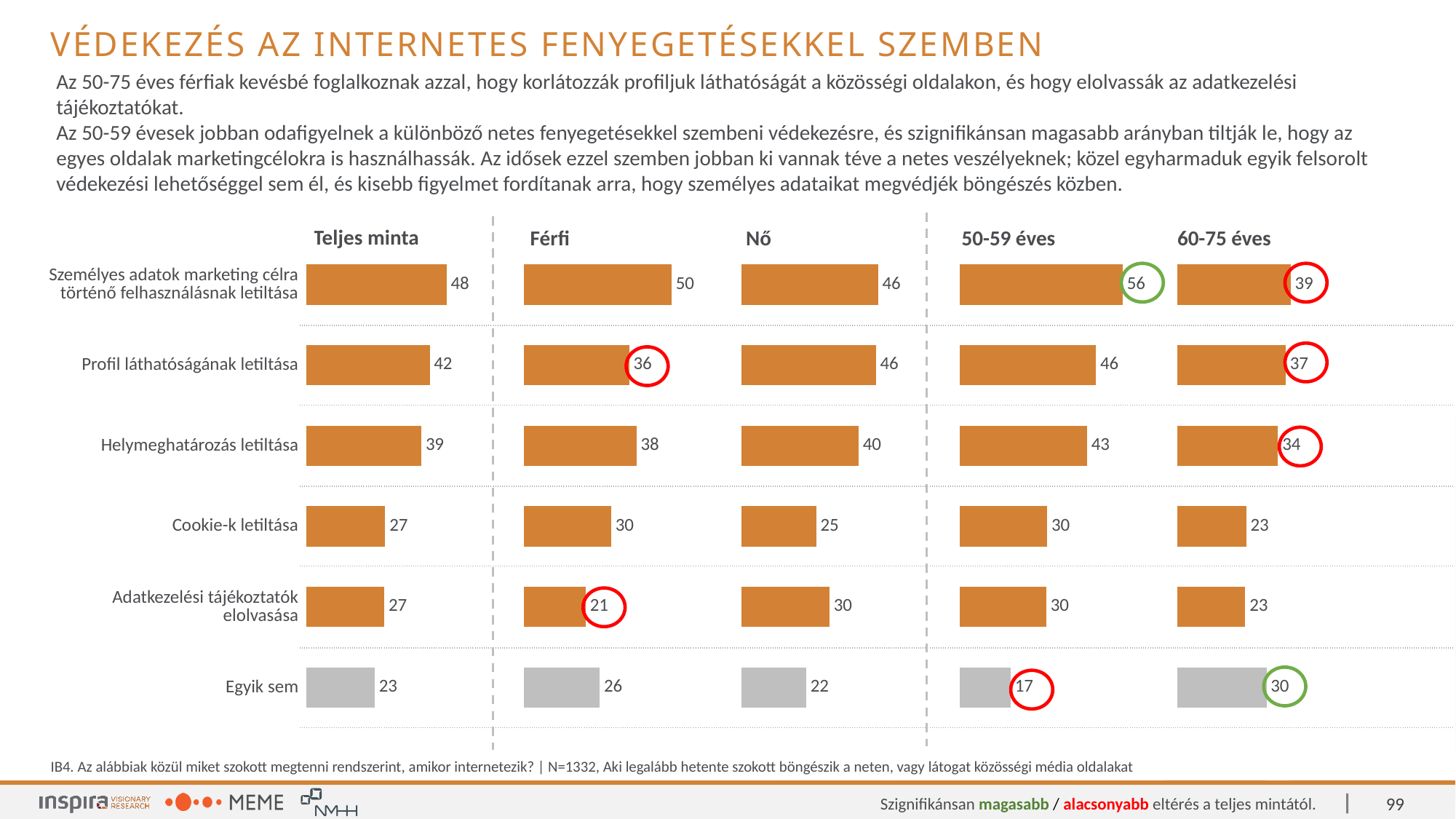
In the "Nő" chart, which category has the lowest value? Egyik sem What is the difference between the "50-59 éves" and "60-75 éves" values for "Személyes adatok marketing célra történő felhasználásnak letiltása"? 17 In the "50-59 éves" chart, which category has the highest value? Személyes adatok marketing célra történő felhasználásnak letiltása In the "Teljes minta" chart, what is the value for "Személyes adatok marketing célra történő felhasználásnak letiltása"? 48 In the "60-75 éves" chart, what is the value for "Egyik sem"? 30 What kind of chart is used on this slide? Bar chart How many categories are shown in the "Teljes minta" chart? 6 For "Profil láthatóságának letiltása", which is larger: the "Férfi" value or the "Nő" value? Nő In the "Férfi" chart, what is the difference between "Cookie-k letiltása" and "Adatkezelési tájékoztatók elolvasása"? 9 In the "Nő" chart, what is the value for "Helymeghatározás letiltása"? 40 In the "Férfi" chart, what is the value for "Adatkezelési tájékoztatók elolvasása"? 21 In the "50-59 éves" chart, which category has the lowest value? Egyik sem